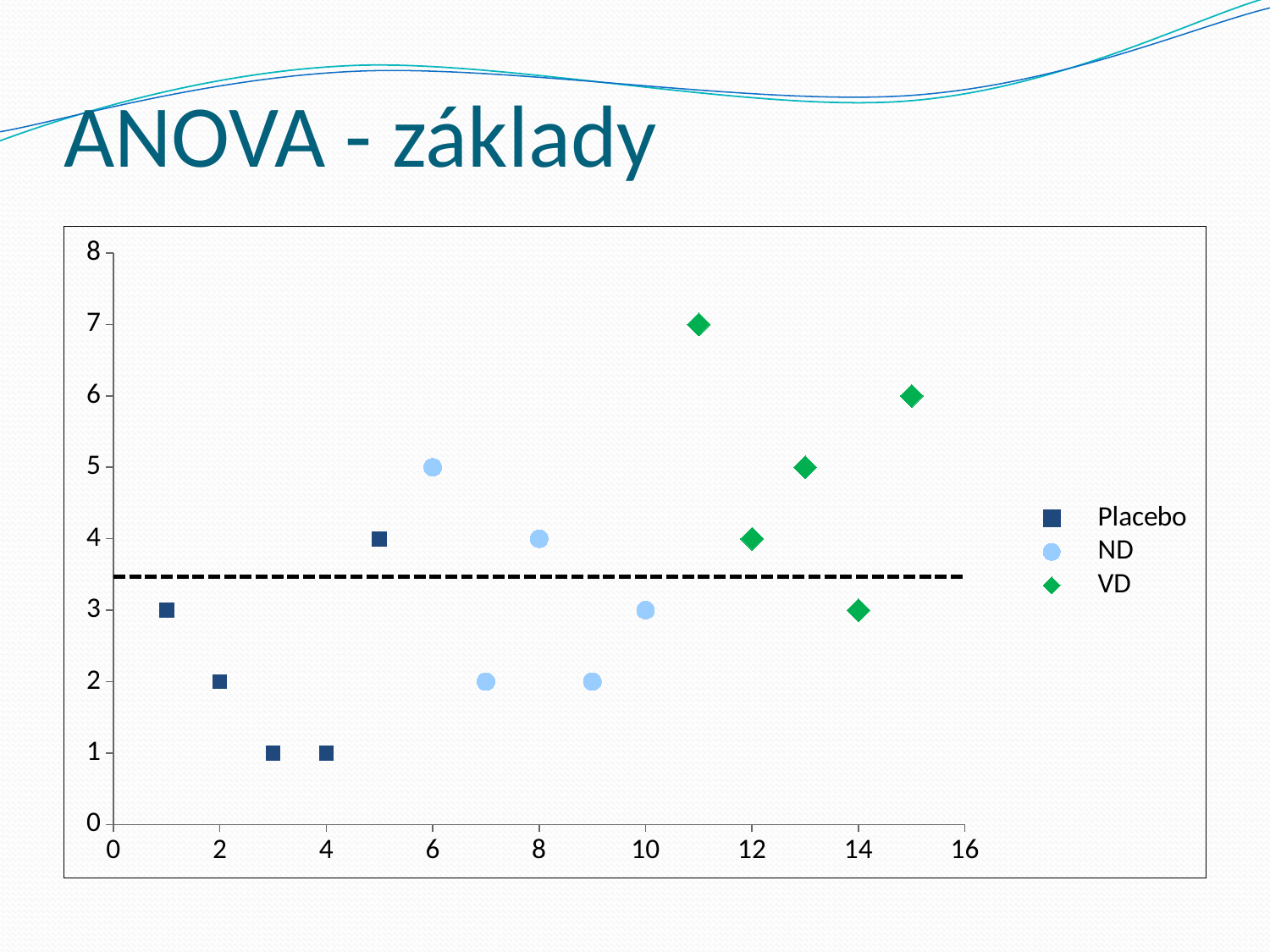
What is the y value of the VD point at x = 11? 7 How many Placebo points are plotted? 5 Which series contains the highest plotted point? VD Which series are listed in the legend? Placebo, ND, VD What is the y value of the ND point at x = 6? 5 What is the y value of the Placebo point at x = 5? 4 What is the difference between the y value of the VD point at x = 15 and the ND point at x = 10? 3 Which has a larger y value: the Placebo point at x = 1 or the VD point at x = 12? the VD point at x = 12 What kind of chart is shown on the slide? scatter chart Is the y value of the VD point at x = 13 greater or less than 4? greater How many series does the legend list? 3 What is the lowest y value plotted on the chart? 1